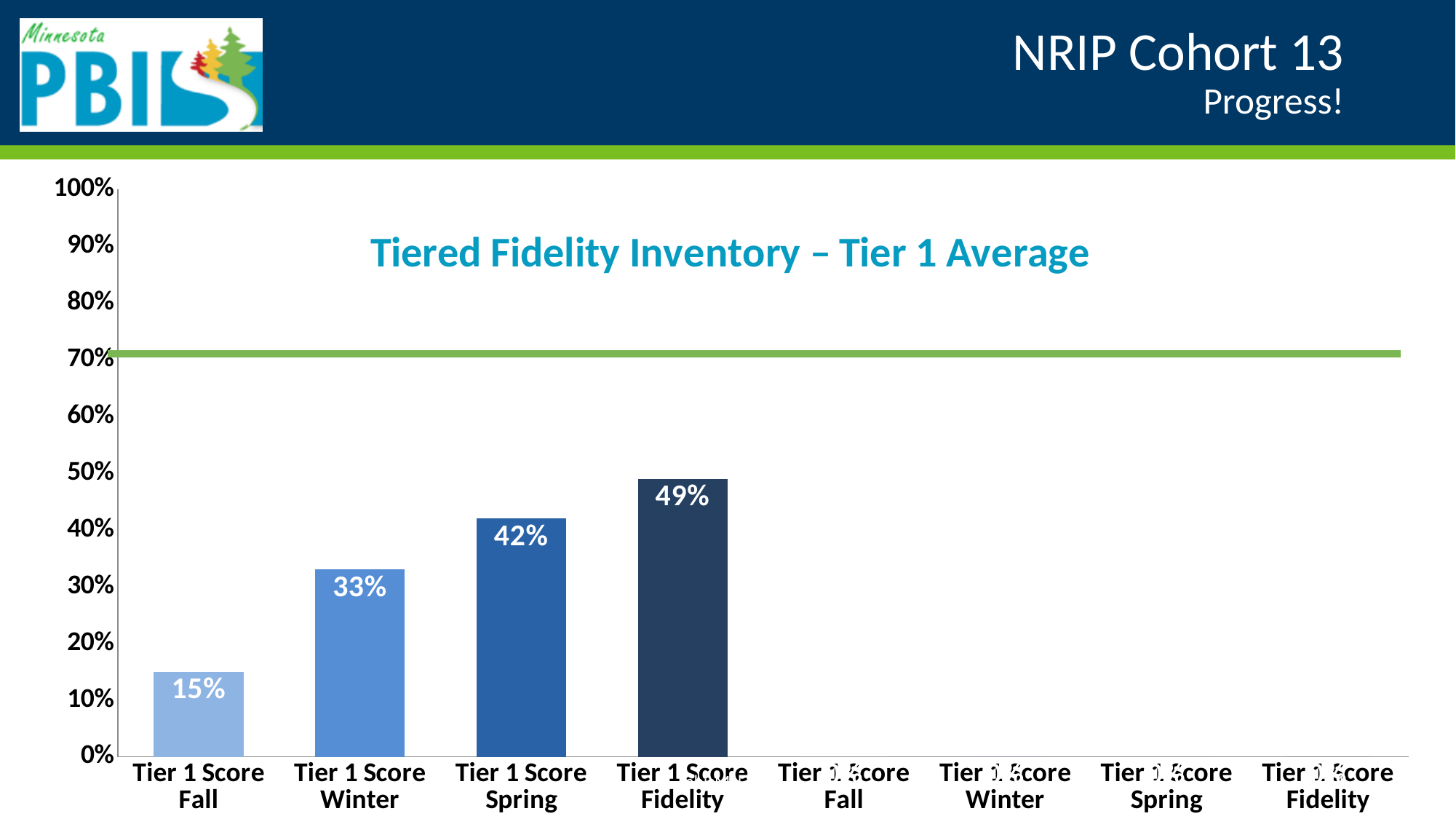
What is the value for Tier 1 Score Spring? 42% Which bar has the highest value? Tier 1 Score Fidelity What is the value for Tier 1 Score Winter? 33% Do the bar values rise or fall from Fall to Fidelity along the x axis? rise Which bar has the lowest value? Tier 1 Score Fall What is the difference between the Tier 1 Score Spring value and the Tier 1 Score Winter value? 9% What is the difference between the Tier 1 Score Fidelity value and the Tier 1 Score Fall value? 34% What kind of chart is shown on the slide? bar chart Is the value for Tier 1 Score Fidelity greater or less than 70%? less Which is larger, the value for Tier 1 Score Winter or Tier 1 Score Spring? Tier 1 Score Spring What is the value for Tier 1 Score Fall? 15% What is the value for Tier 1 Score Fidelity? 49%